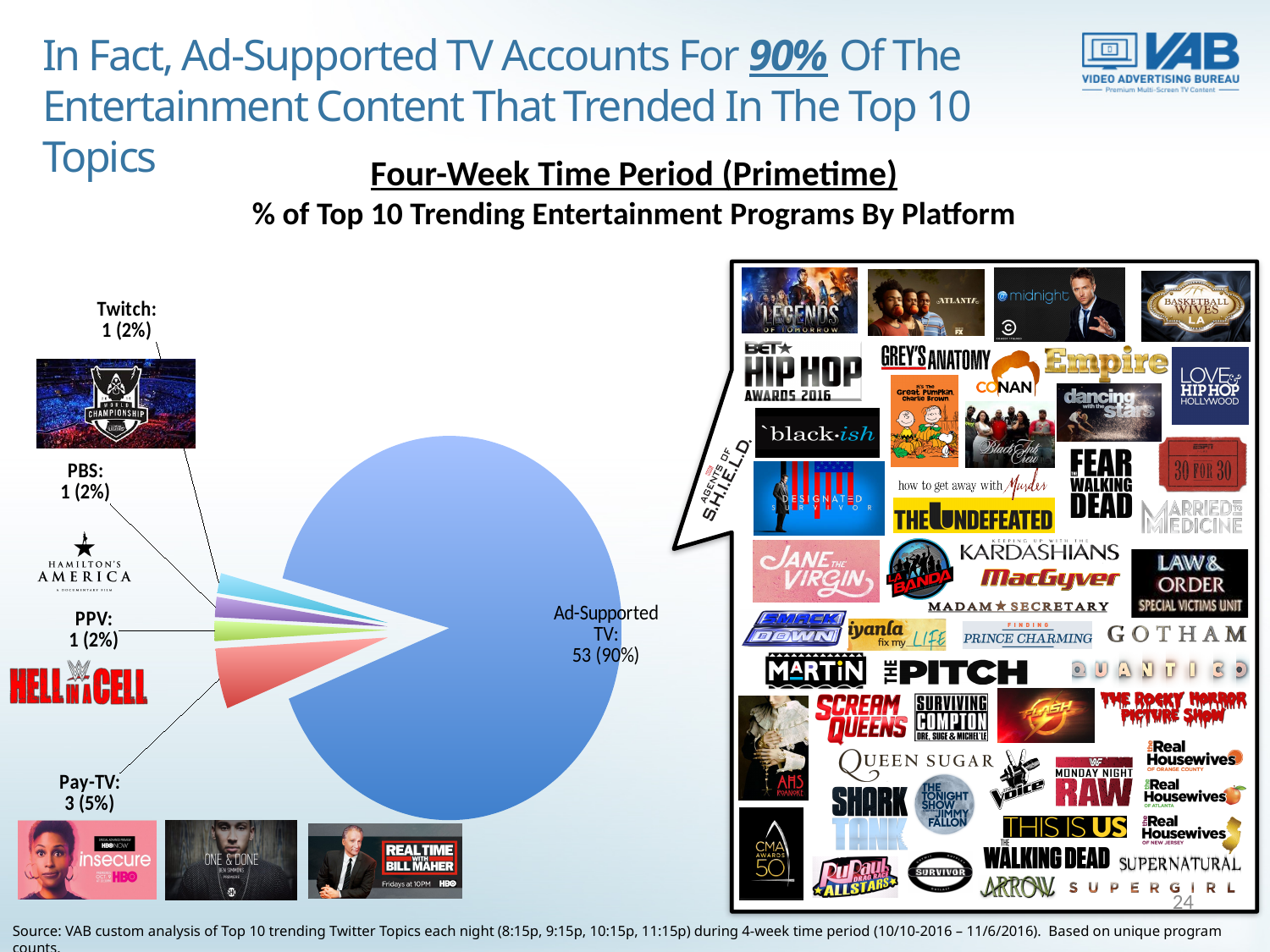
What is the combined program count of Twitch, PBS and PPV? 3 What is the difference in program count between Ad-Supported TV and Pay-TV? 50 What is the value shown for Pay-TV in the pie chart? 3 (5%) Which platform has the largest slice of the pie chart? Ad-Supported TV What is the value shown for Twitch in the pie chart? 1 (2%) What type of chart is shown on the slide? pie chart Which platform has the second-largest slice of the pie chart? Pay-TV What is the value shown for Ad-Supported TV in the pie chart? 53 (90%) What percentage share does PBS have in the pie chart? 2% How many slices does the pie chart have? 5 What is the subtitle printed directly above the pie chart describing what it measures? % of Top 10 Trending Entertainment Programs By Platform Which has a larger share of the pie: Pay-TV or PPV? Pay-TV